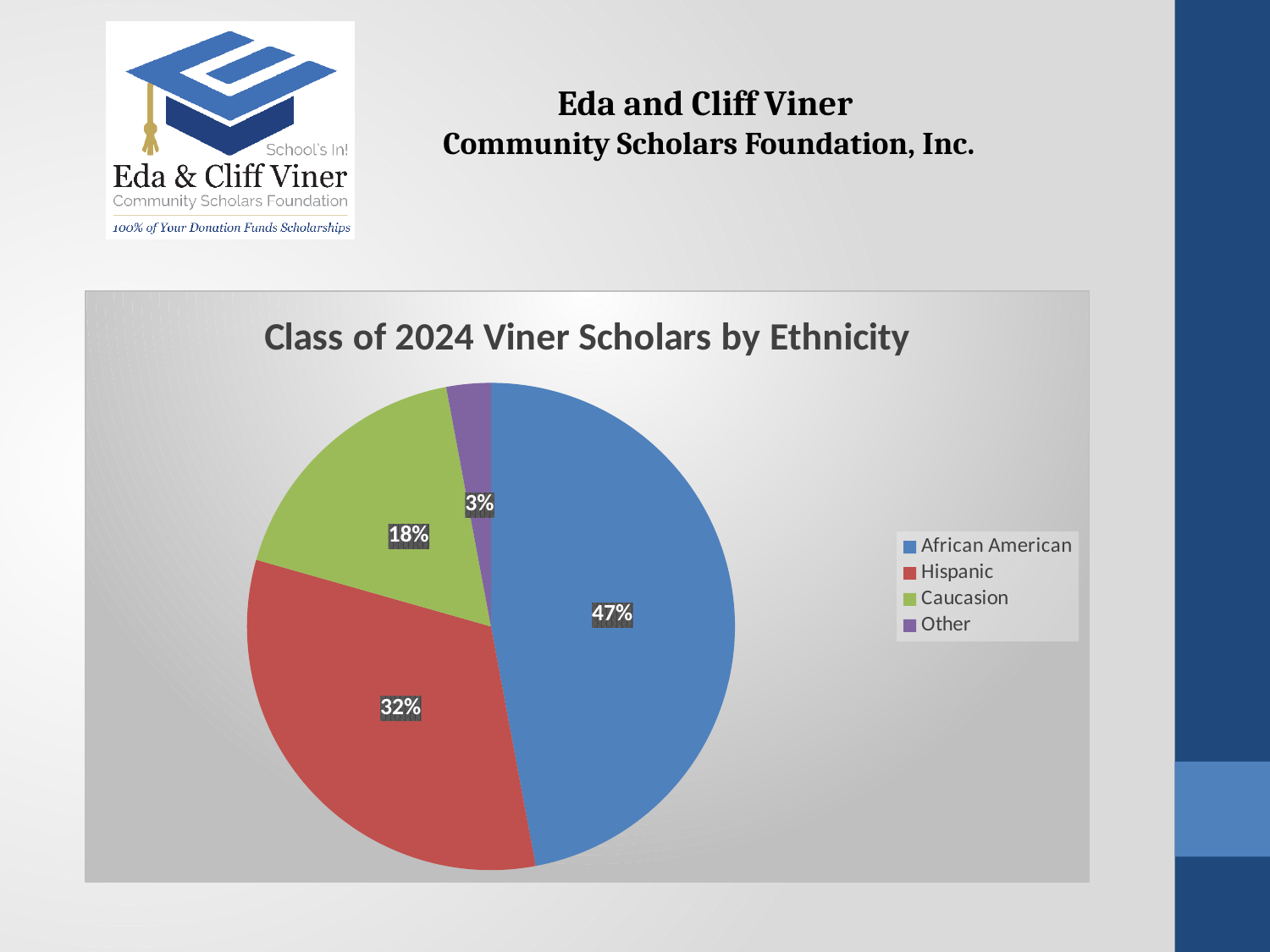
What percentage of the Class of 2024 Viner Scholars are Hispanic? 32% Which colour represents Caucasian in the pie chart? Green How many ethnicity categories are shown in the pie chart? 4 What is the title of the chart? Class of 2024 Viner Scholars by Ethnicity What kind of chart is shown on the slide? Pie chart What percentage of the Class of 2024 Viner Scholars are Caucasian? 18% What percentage of the Class of 2024 Viner Scholars fall under Other? 3% What percentage of the Class of 2024 Viner Scholars are African American? 47% What is the difference in percentage points between the African American and Hispanic shares? 15 Which ethnicity has the largest share of the Class of 2024 Viner Scholars? African American Which share is larger, Hispanic or Caucasian? Hispanic Which ethnicity has the smallest share of the Class of 2024 Viner Scholars? Other